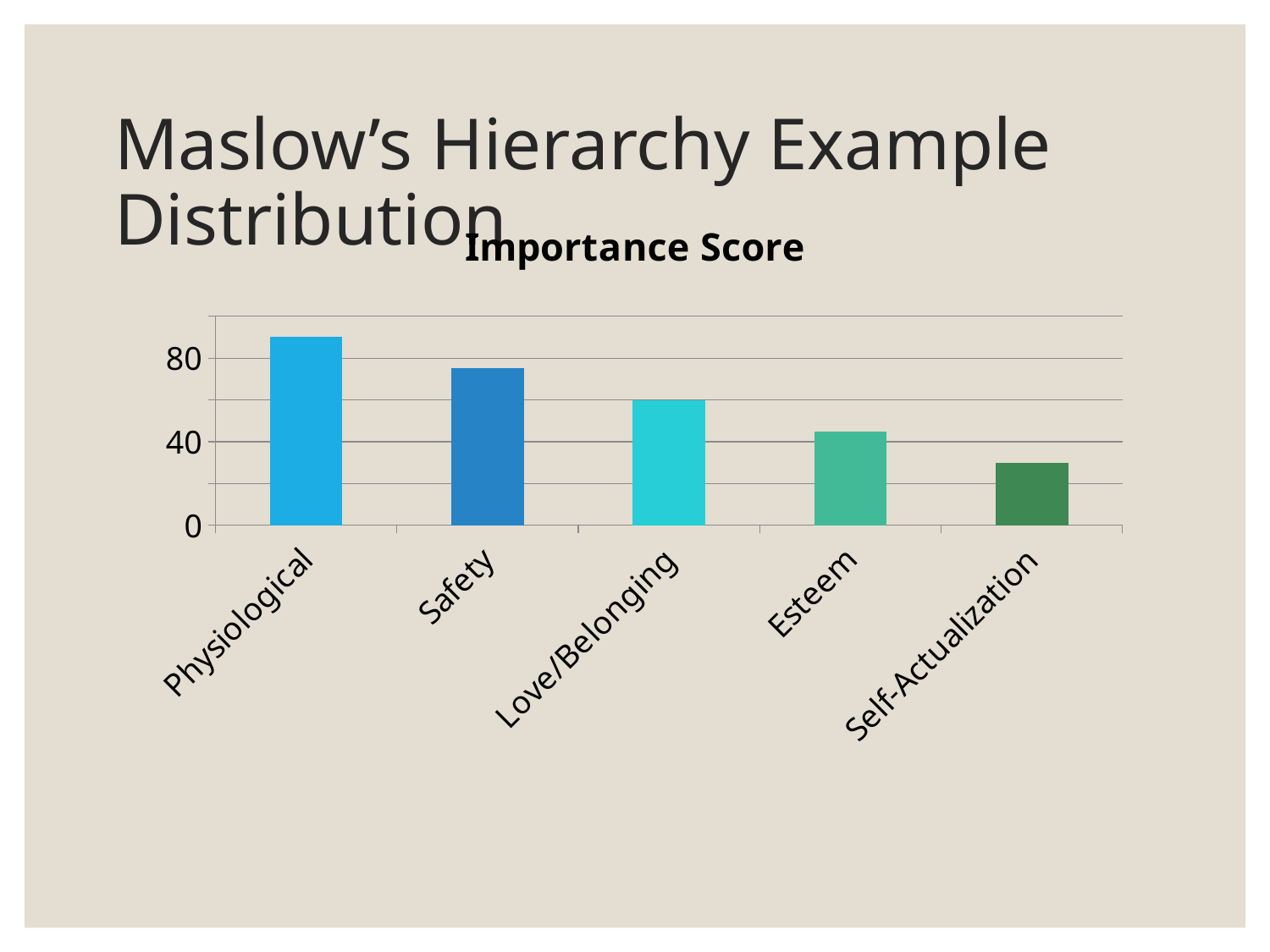
Is the value for Self-Actualization greater or less than 40? less Which category has the highest importance score? Physiological Is the value for Love/Belonging greater or less than 40? greater Do the values rise or fall moving from left to right along the x axis? fall Which category has the lowest importance score? Self-Actualization Which is larger, the value for Love/Belonging or the value for Self-Actualization? Love/Belonging Is the value for Physiological greater or less than 80? greater Which is larger, the value for Safety or the value for Esteem? Safety How many categories are plotted in the chart? 5 What is the title of the chart? Importance Score What kind of chart is shown on the slide? bar chart